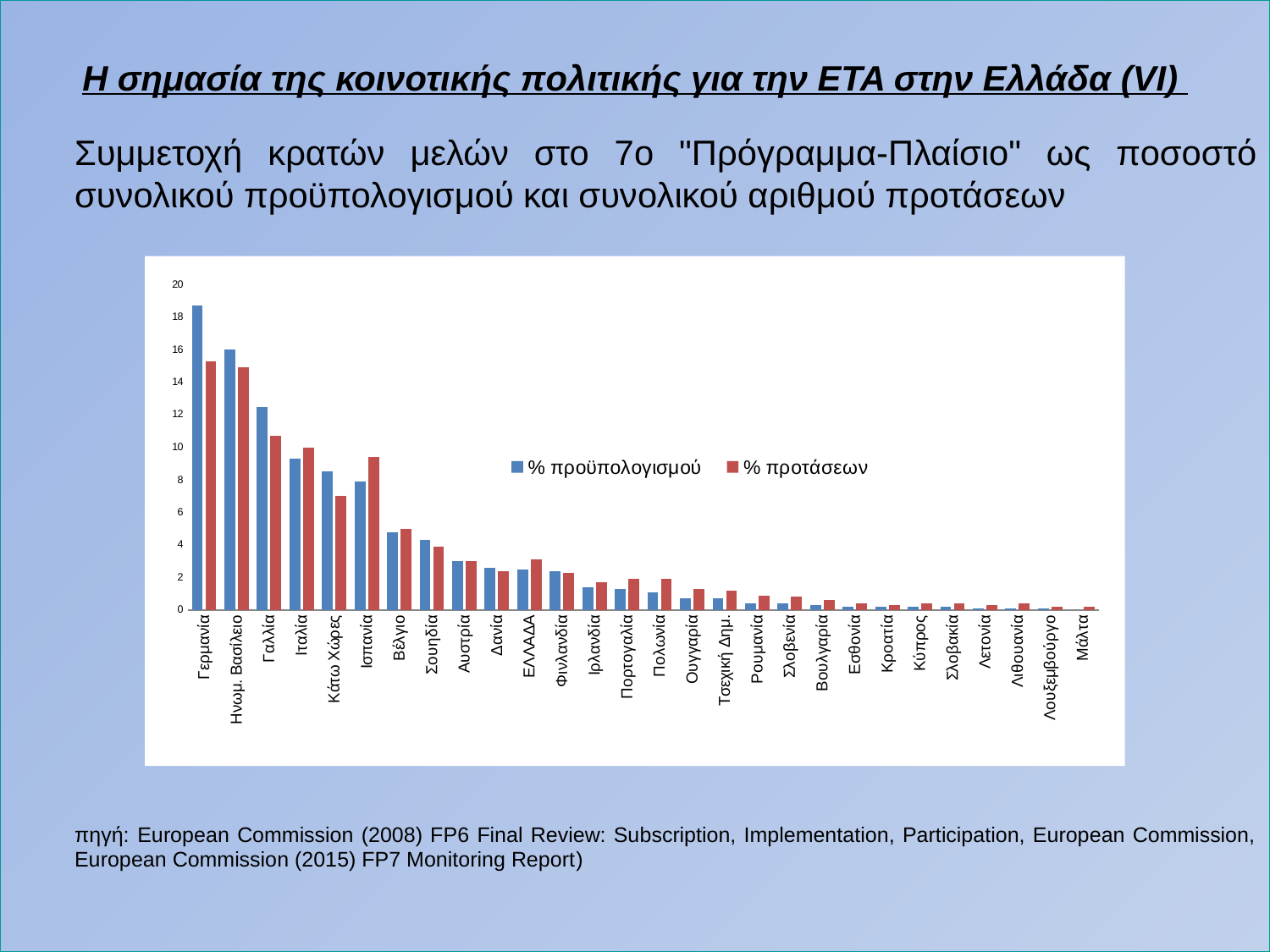
Is the % προϋπολογισμού value for Γαλλία greater or less than 10? greater Is the % προτάσεων value for Ισπανία greater or less than 8? greater Which country has the highest value for % προϋπολογισμού? Γερμανία For Ισπανία, which is larger: % προϋπολογισμού or % προτάσεων? % προτάσεων Is the % προϋπολογισμού value for Γερμανία greater or less than 16? greater What kind of chart is shown on the slide? bar chart How many countries are shown on the x axis? 28 How many series does the legend list? 2 What are the two series named in the legend? % προϋπολογισμού and % προτάσεων For Γερμανία, which is larger: % προϋπολογισμού or % προτάσεων? % προϋπολογισμού Do the % προϋπολογισμού values generally rise or fall from left to right along the x axis? fall